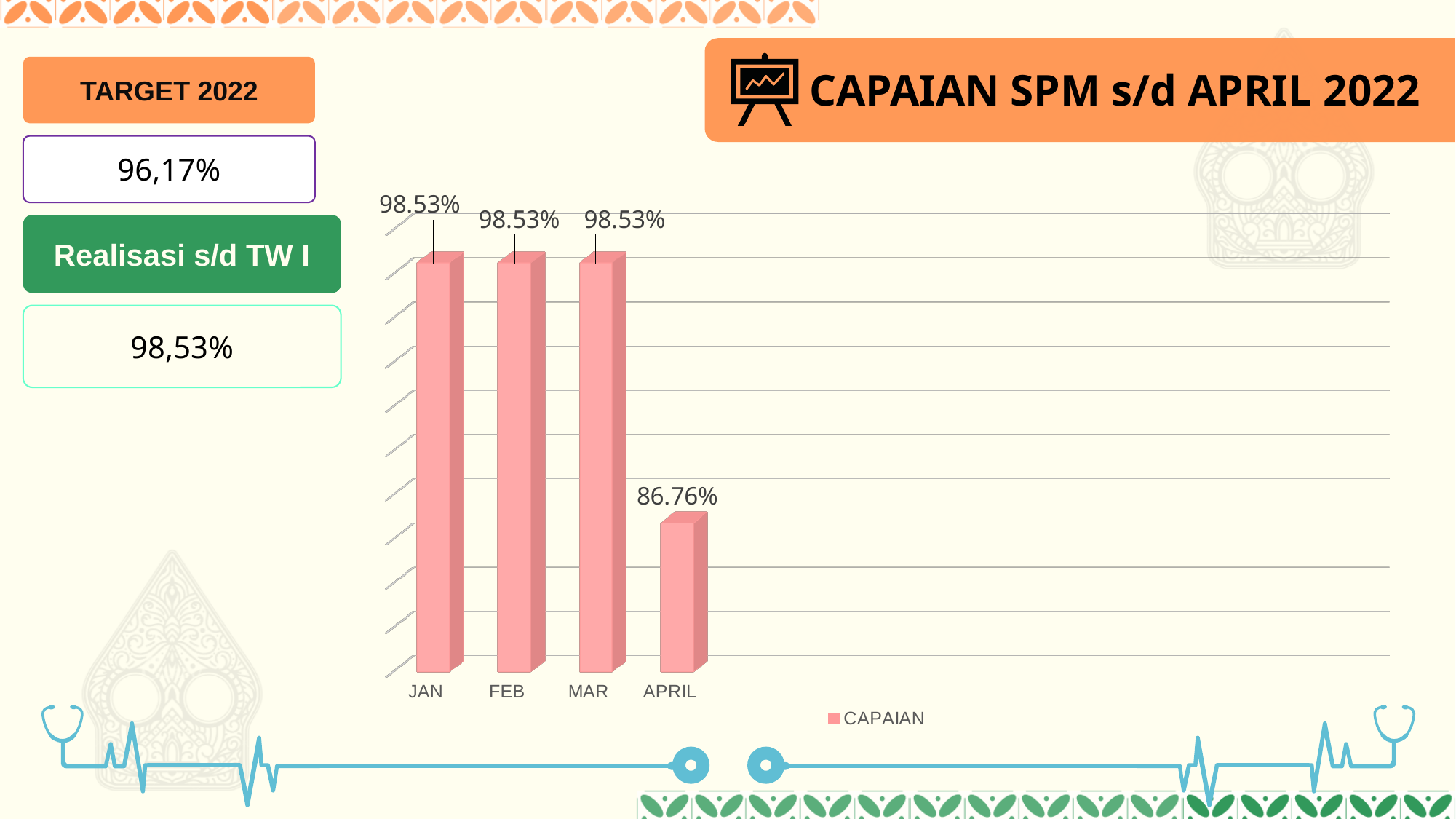
What is the name of the series in the legend? CAPAIAN Do the values rise or fall from MAR to APRIL? fall How many months are shown on the x axis? 4 What is the value for APRIL? 86.76% Which month has the lowest value? APRIL What kind of chart is shown? bar chart What is the difference between the values for MAR and APRIL? 11.77% Which is larger, the value for FEB or the value for APRIL? FEB How many series does the legend list? 1 What is the value for MAR? 98.53% What is the value for JAN? 98.53% What is the title of the chart? CAPAIAN SPM s/d APRIL 2022